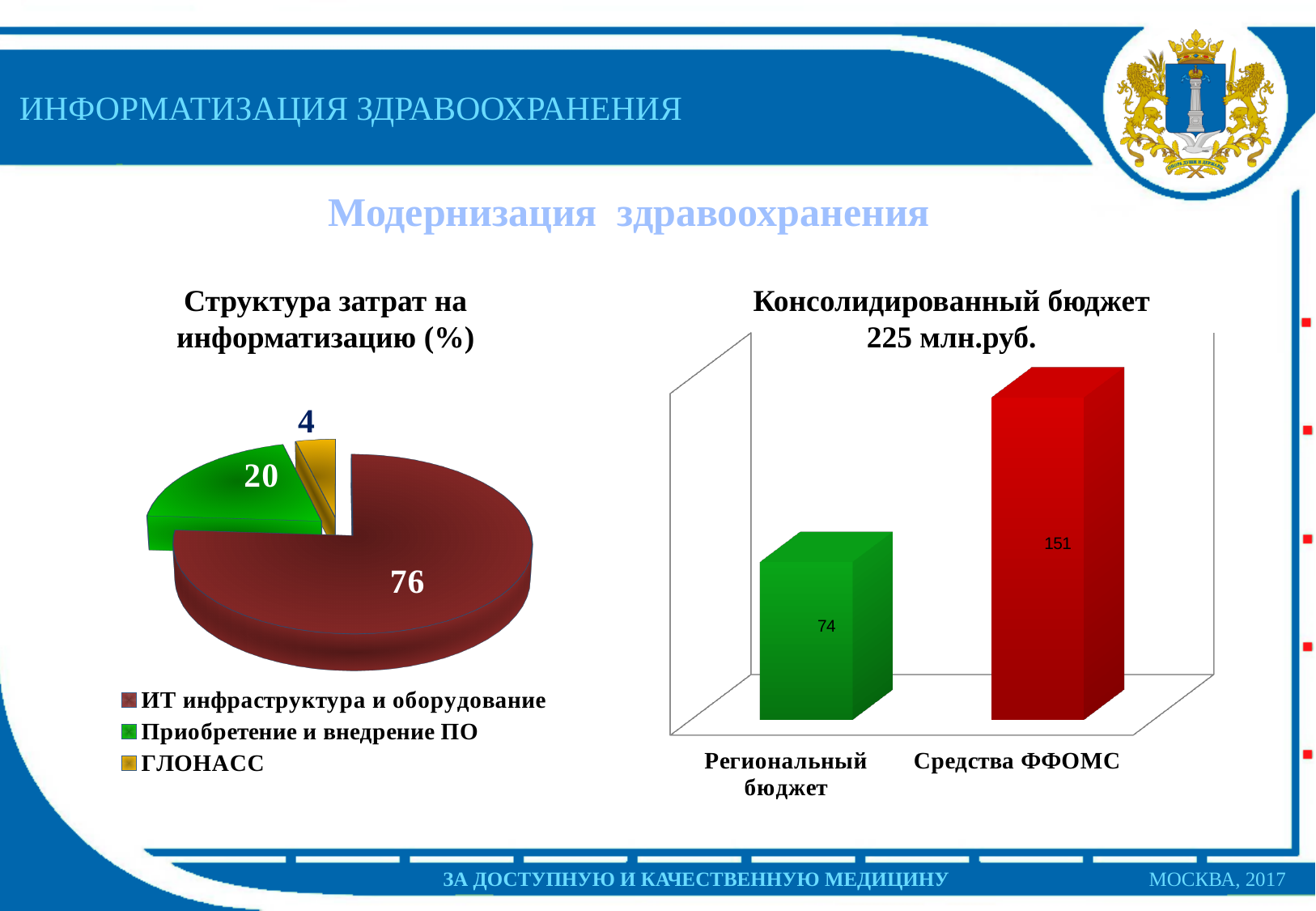
In the chart 'Консолидированный бюджет 225 млн.руб.', which category is larger, 'Региональный бюджет' or 'Средства ФФОМС'? Средства ФФОМС In the chart 'Консолидированный бюджет 225 млн.руб.', what is the value for 'Региональный бюджет'? 74 In the pie chart 'Структура затрат на информатизацию (%)', which category has the smallest slice? ГЛОНАСС In the pie chart 'Структура затрат на информатизацию (%)', what colour is the 'Приобретение и внедрение ПО' slice? Green In the pie chart 'Структура затрат на информатизацию (%)', what is the difference between 'ИТ инфраструктура и оборудование' and 'Приобретение и внедрение ПО'? 56 In the chart 'Консолидированный бюджет 225 млн.руб.', what is the difference between 'Средства ФФОМС' and 'Региональный бюджет'? 77 In the pie chart 'Структура затрат на информатизацию (%)', what is the value for 'ИТ инфраструктура и оборудование'? 76 In the chart 'Консолидированный бюджет 225 млн.руб.', what is the value for 'Средства ФФОМС'? 151 In the pie chart 'Структура затрат на информатизацию (%)', how many categories does the legend list? 3 What type of chart is 'Консолидированный бюджет 225 млн.руб.'? Bar chart In the pie chart 'Структура затрат на информатизацию (%)', which category has the largest slice? ИТ инфраструктура и оборудование In the pie chart 'Структура затрат на информатизацию (%)', what is the value for 'ГЛОНАСС'? 4